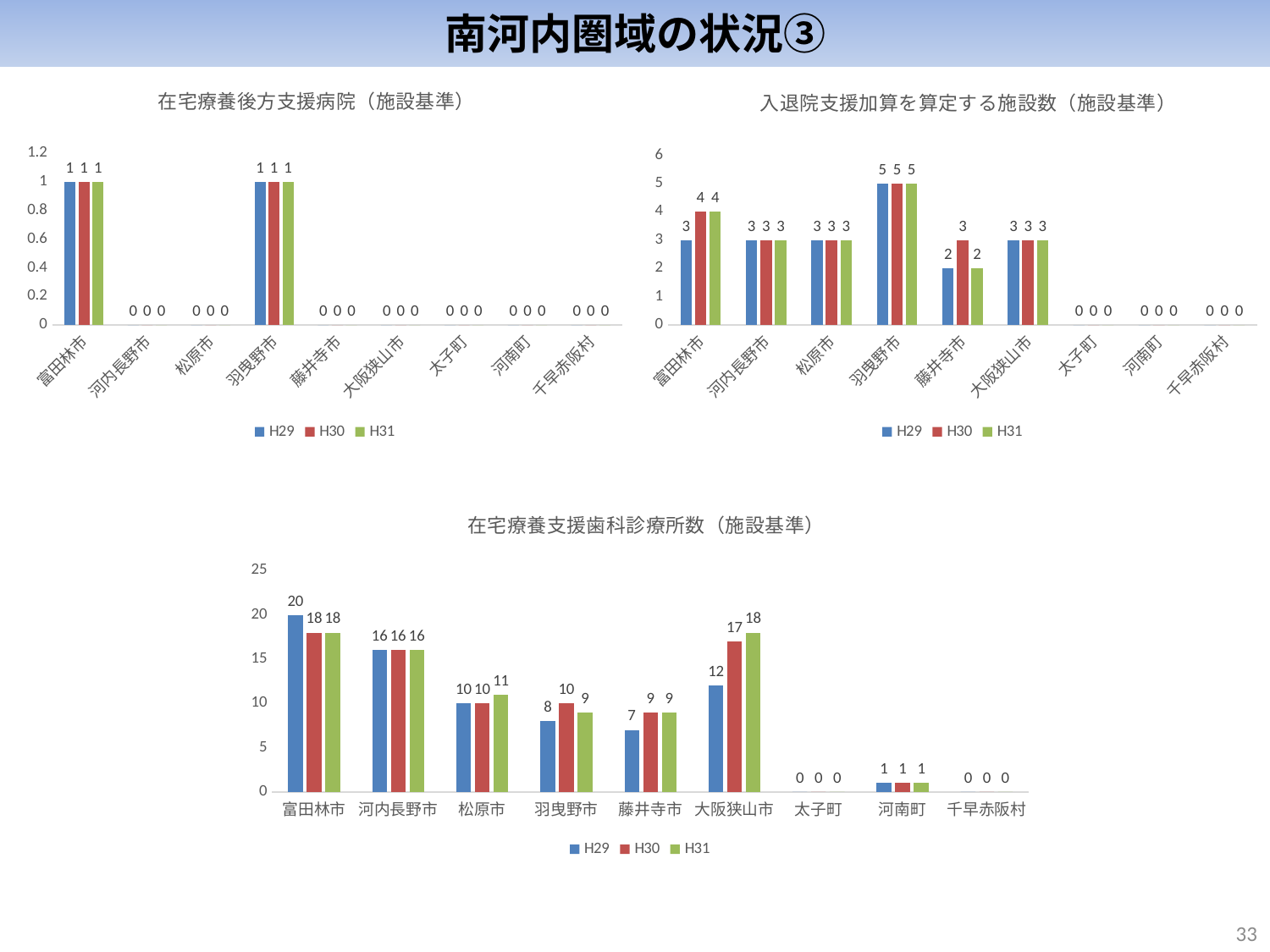
In the chart titled 在宅療養支援歯科診療所数（施設基準）, which is larger: the H30 value for 羽曳野市 or the H30 value for 藤井寺市? 羽曳野市 How many series does the legend list in the chart titled 入退院支援加算を算定する施設数（施設基準）? 3 In the chart titled 在宅療養後方支援病院（施設基準）, which categories have a value of 1 in all three years? 富田林市 and 羽曳野市 What kind of chart is the bottom chart titled 在宅療養支援歯科診療所数（施設基準）? Bar chart In the chart titled 入退院支援加算を算定する施設数（施設基準）, what is the H30 value for 藤井寺市? 3 In the chart titled 在宅療養支援歯科診療所数（施設基準）, do the values for 大阪狭山市 rise or fall from H29 to H31? Rise In the chart titled 在宅療養支援歯科診療所数（施設基準）, what is the H29 value for 富田林市? 20 In the chart titled 在宅療養支援歯科診療所数（施設基準）, is the H29 value for 河内長野市 greater or less than 15? greater In the chart titled 在宅療養支援歯科診療所数（施設基準）, which category has the highest H31 value? 富田林市 and 大阪狭山市 (both 18) In the chart titled 入退院支援加算を算定する施設数（施設基準）, which category has the highest H29 value? 羽曳野市 In the chart titled 在宅療養支援歯科診療所数（施設基準）, what is the difference between the H31 value for 大阪狭山市 and the H29 value for 大阪狭山市? 6 How many categories are shown on the x axis of the chart titled 在宅療養後方支援病院（施設基準）? 9